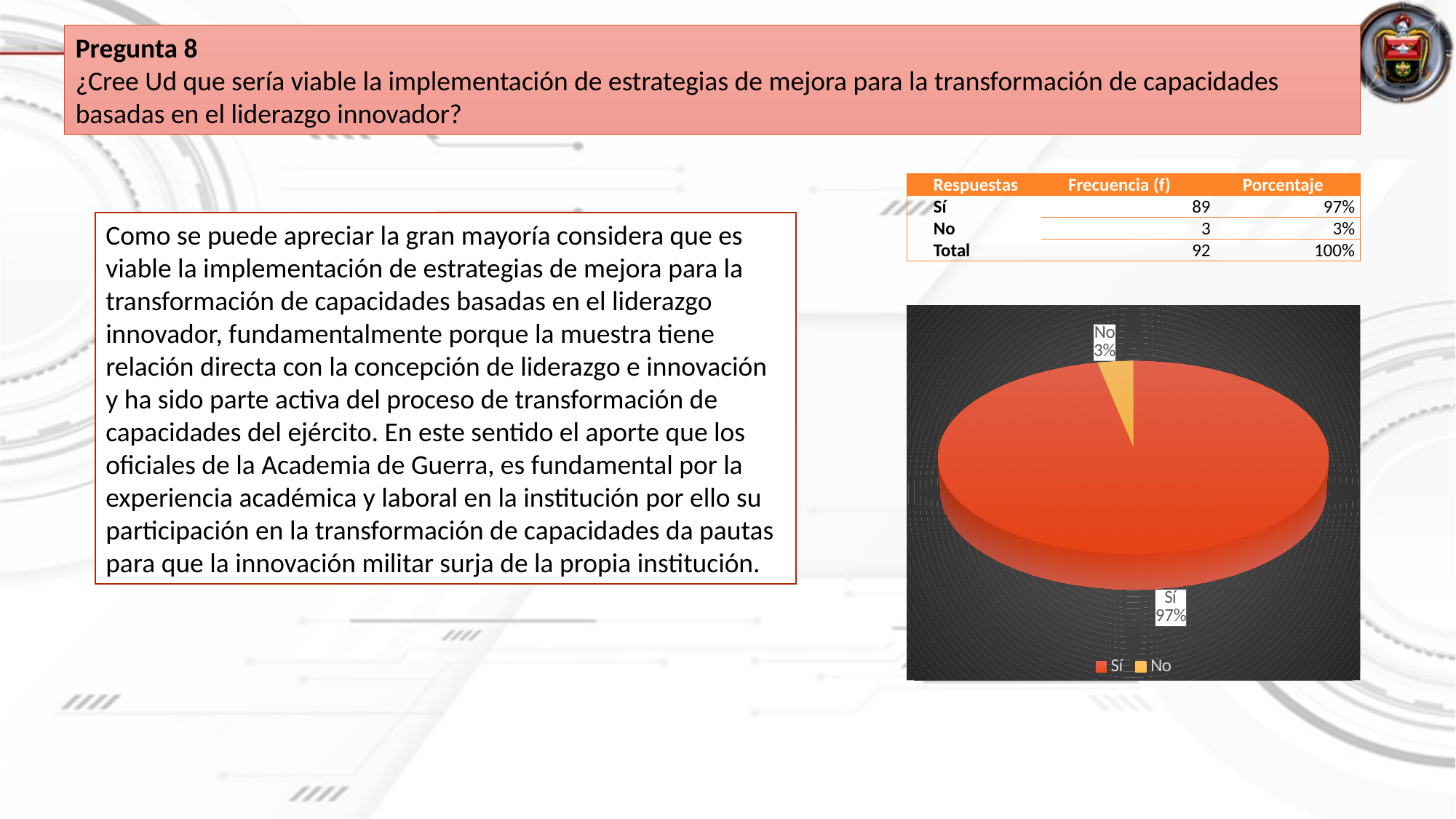
Which slice of the pie chart is the smallest? No What colour is the 'Sí' slice in the pie chart? red How many slices does the pie chart have? 2 What percentage does the 'No' slice of the pie chart show? 3% Which slice of the pie chart is the largest? Sí Which is larger in the pie chart, the 'Sí' slice or the 'No' slice? Sí What kind of chart is shown on the slide? pie chart What colour is the 'No' slice in the pie chart? orange/yellow What is the difference in percentage points between the 'Sí' and 'No' slices of the pie chart? 94 What percentage does the 'Sí' slice of the pie chart show? 97% How many entries does the pie chart's legend list? 2